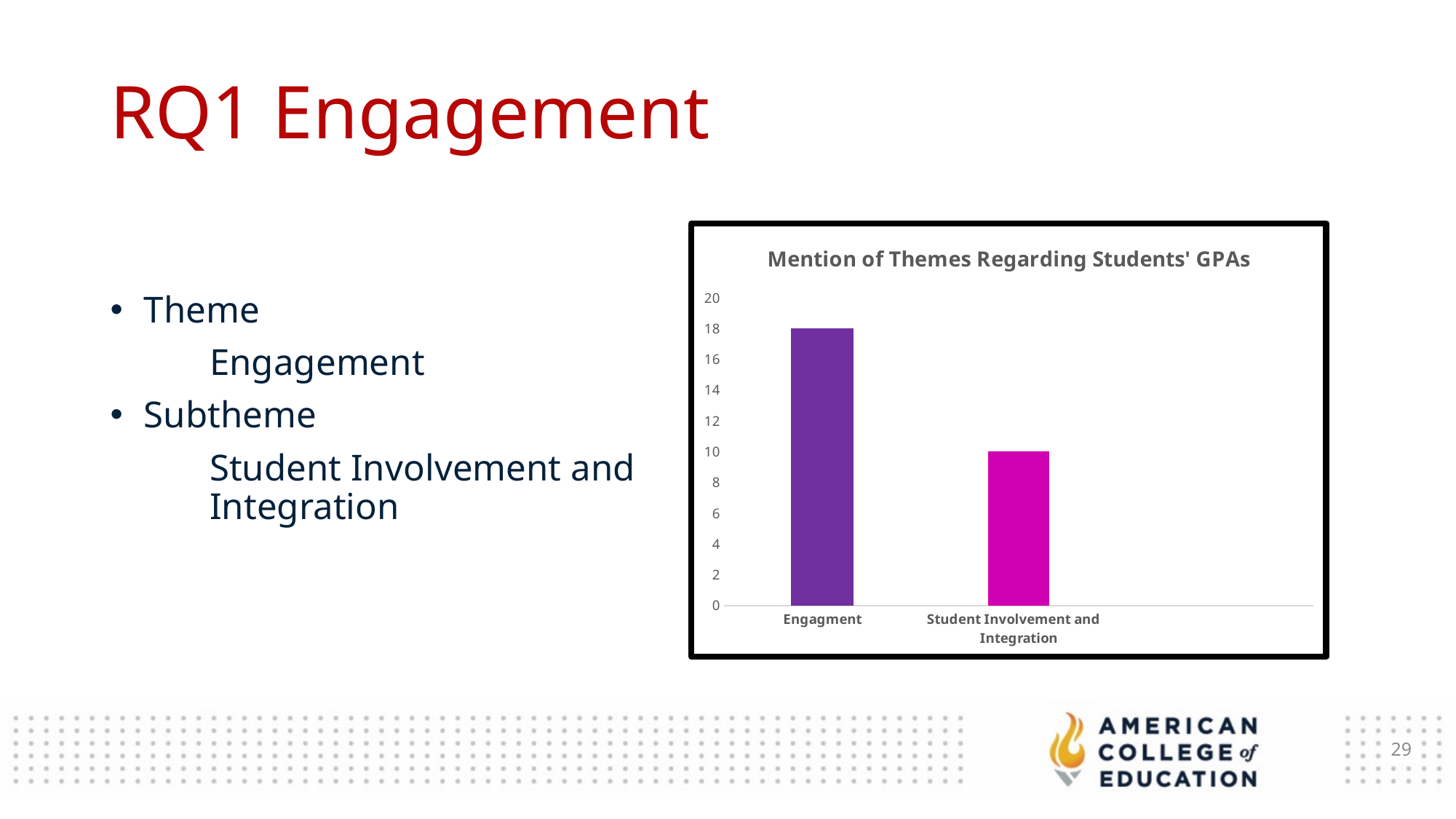
What is the highest value shown on the vertical axis of the chart? 20 Which category has the lowest value in the chart? Student Involvement and Integration Is the value for Student Involvement and Integration greater or less than 12? less What is the value for Engagment in the chart? 18 Which category has the highest value in the chart? Engagment Is the value for Engagment greater or less than 16? greater What is the title of the chart? Mention of Themes Regarding Students' GPAs What is the value for Student Involvement and Integration in the chart? 10 What kind of chart is shown on the slide? bar chart How many categories are plotted in the chart? 2 What is the difference between the values for Engagment and Student Involvement and Integration? 8 Which is larger, the value for Engagment or the value for Student Involvement and Integration? Engagment